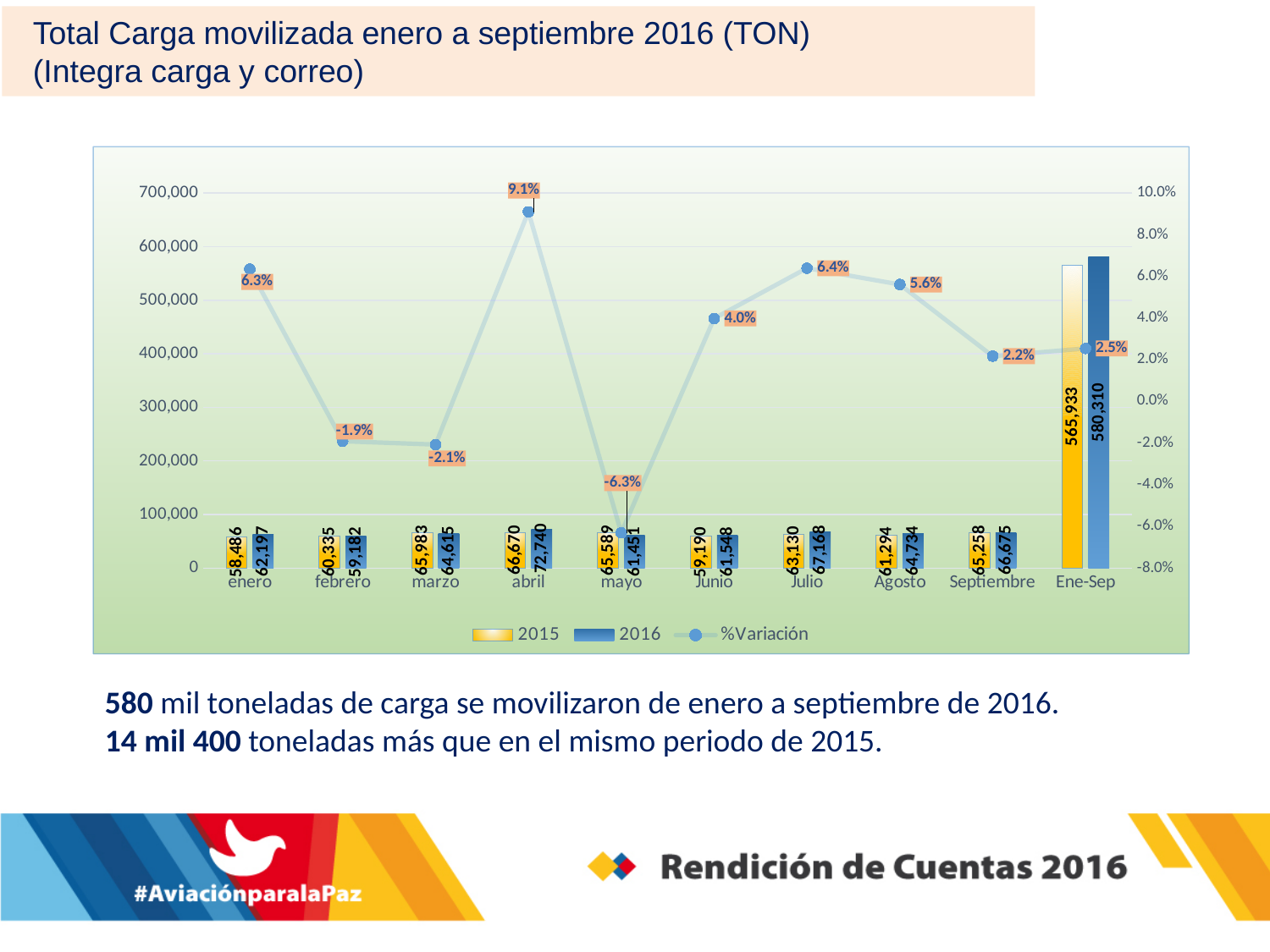
What is the 2016 value for the Ene-Sep category? 580,310 What is the 2015 value for septiembre? 65,258 How many series does the legend list? 3 Among the monthly categories, which month has the highest 2016 value? abril Which category has the lowest %Variación value? mayo For febrero, which series has the larger value, 2015 or 2016? 2015 Which category has the highest %Variación value? abril What is the %Variación value for mayo? -6.3% What is the difference between the 2016 and 2015 values for abril? 6,070 How many categories are shown on the x axis? 10 What is the difference between the 2016 and 2015 values for Ene-Sep? 14,377 What is the 2016 value for abril? 72,740